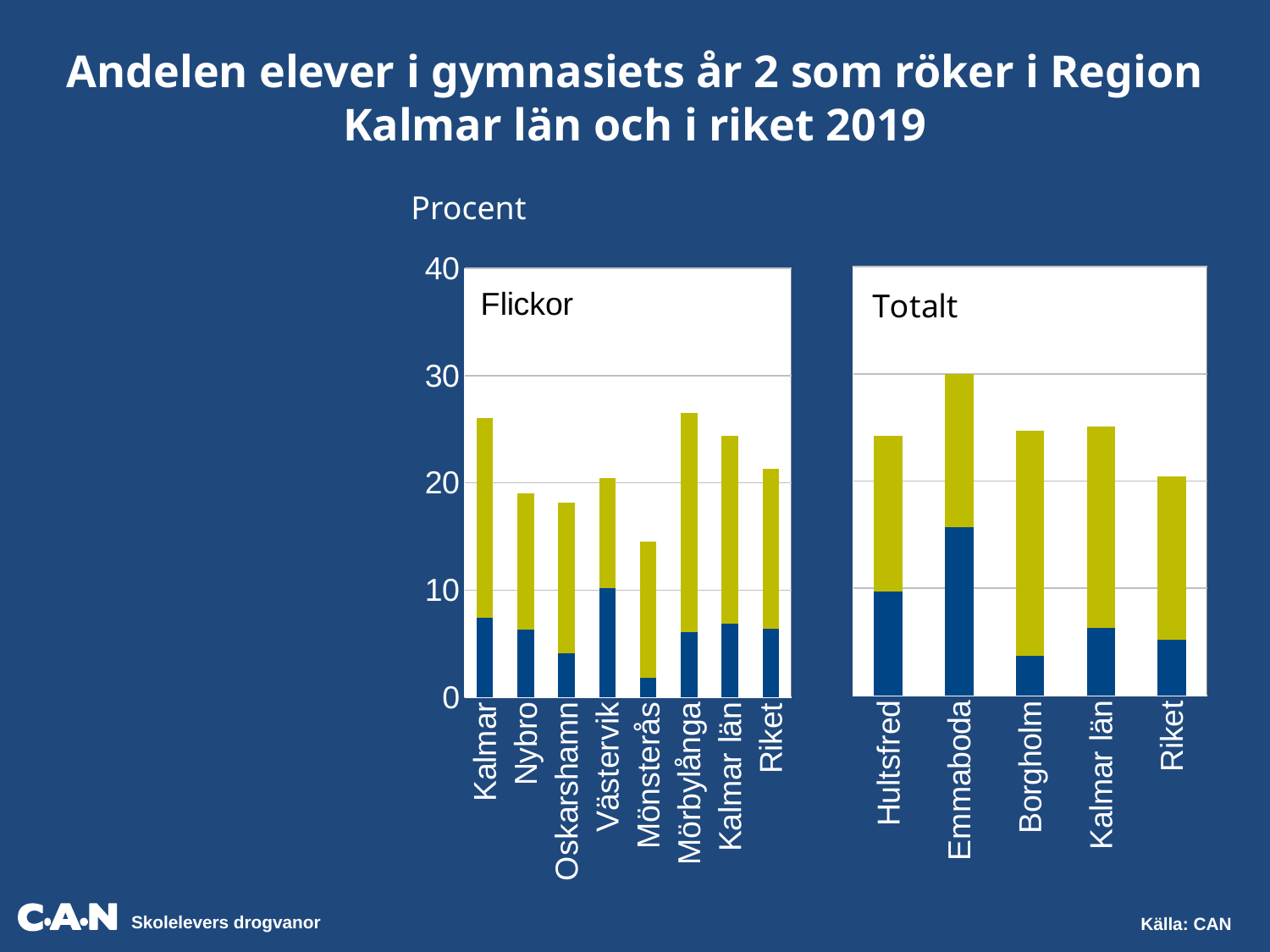
In the Flickor chart, is the total bar for Mönsterås greater or less than 20? less In the Flickor chart, which category has the lowest total bar? Mönsterås In the Totalt chart, which category has the lowest total bar? Riket In the Totalt chart, which has the taller total bar, Emmaboda or Riket? Emmaboda In the Totalt chart, is the total bar for Riket greater or less than 30? less In the Flickor chart, which has the taller total bar, Kalmar or Nybro? Kalmar In the Totalt chart, which category has the highest total bar? Emmaboda What kind of chart is the Flickor chart on the left? bar chart How many categories are shown on the x axis of the Totalt chart? 5 In the Flickor chart, is the total bar for Kalmar greater or less than 20? greater How many categories are shown on the x axis of the Flickor chart? 8 What unit label is shown above the y axis of the charts? Procent